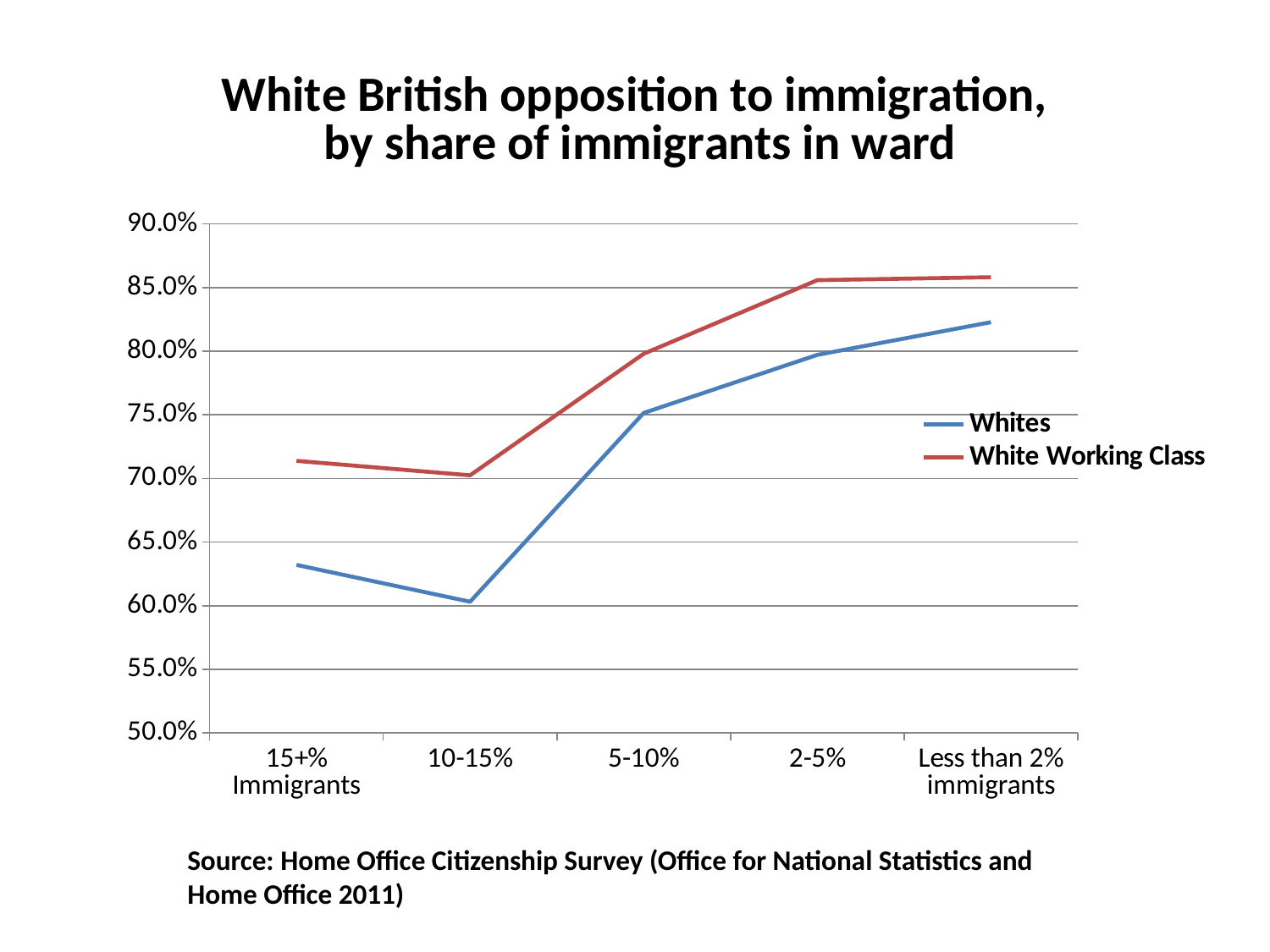
Moving from 10-15% wards to Less than 2% immigrants wards, do the values for Whites rise or fall? rise What kind of chart is shown on the slide? line chart For which ward category is the Whites series lowest? 10-15% For which ward category is the Whites series highest? Less than 2% immigrants Is the value for Whites in 5-10% wards greater or less than 70.0%? greater Is the value for White Working Class in 15+% Immigrants wards greater or less than 70.0%? greater Is the value for Whites in 10-15% wards greater or less than 65.0%? less In 2-5% wards, which series has the higher value, Whites or White Working Class? White Working Class How many series does the legend list? 2 How many ward categories are shown along the x axis? 5 Which colour is used for the White Working Class line? red